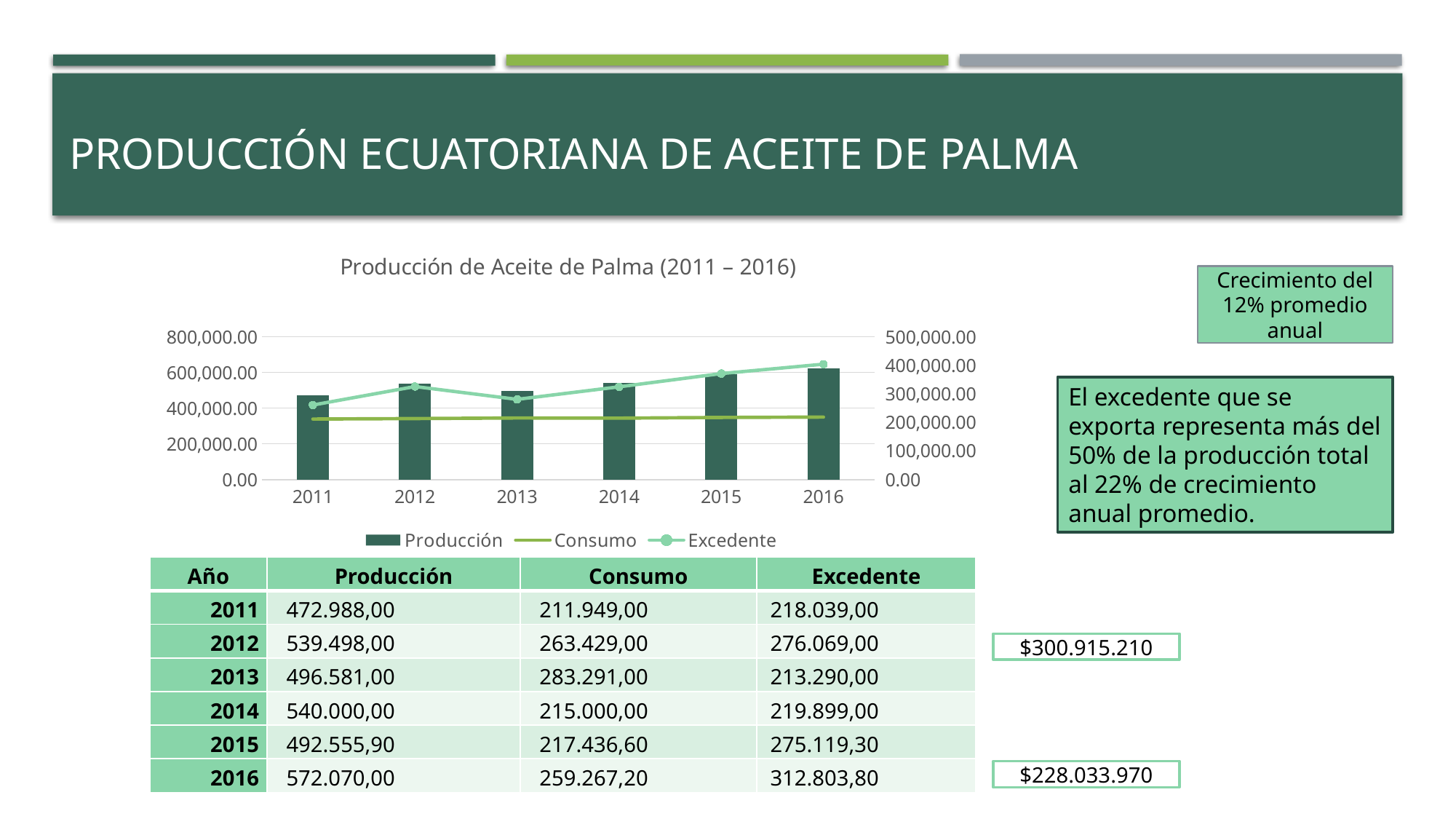
Which year has the lowest Excedente point? 2011 How many series does the chart legend list? 3 Is the Producción bar for 2012 greater or less than 400,000.00 on the left axis? greater Does the Excedente line generally rise or fall from 2011 to 2016? rise Is the Producción bar for 2011 greater or less than 600,000.00 on the left axis? less Which year has the highest Excedente point? 2016 What is the title of the chart? Producción de Aceite de Palma (2011 – 2016) How many years are plotted along the x axis of the chart? 6 What kind of chart is shown on the slide? A combined bar and line chart Which year has the tallest Producción bar? 2016 Is the Producción bar for 2012 taller or shorter than the bar for 2011? taller Which year has the shortest Producción bar? 2011